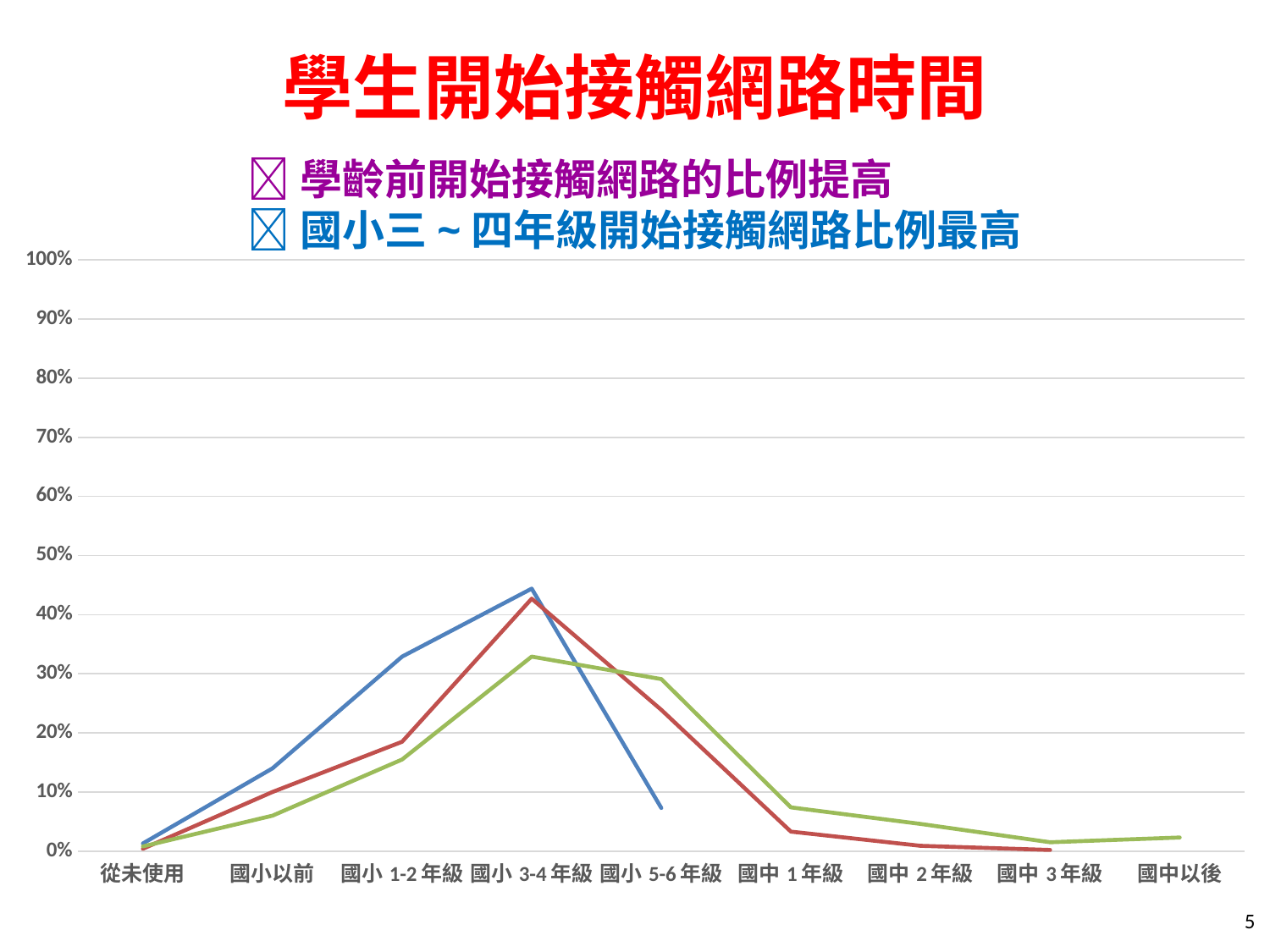
How many categories are shown along the x axis of the chart? 9 What is the title of the slide containing the chart? 學生開始接觸網路時間 At which category does the blue line reach its highest value? 國小 3-4 年級 At 國小 1-2 年級, which line has the larger value, the blue line or the red line? the blue line At which category does the green line reach its highest value? 國小 3-4 年級 Is the value of the green line at 國小 3-4 年級 greater or less than 30%? greater How many lines are plotted in the chart? 3 Does the red line rise or fall from 國小 3-4 年級 to 國中 3 年級? fall What kind of chart is shown on the slide? Line chart At 國小 5-6 年級, which line has the larger value, the blue line or the green line? the green line Is the value of the blue line at 國小 3-4 年級 greater or less than 40%? greater Is the value of the red line at 國中 1 年級 greater or less than 10%? less